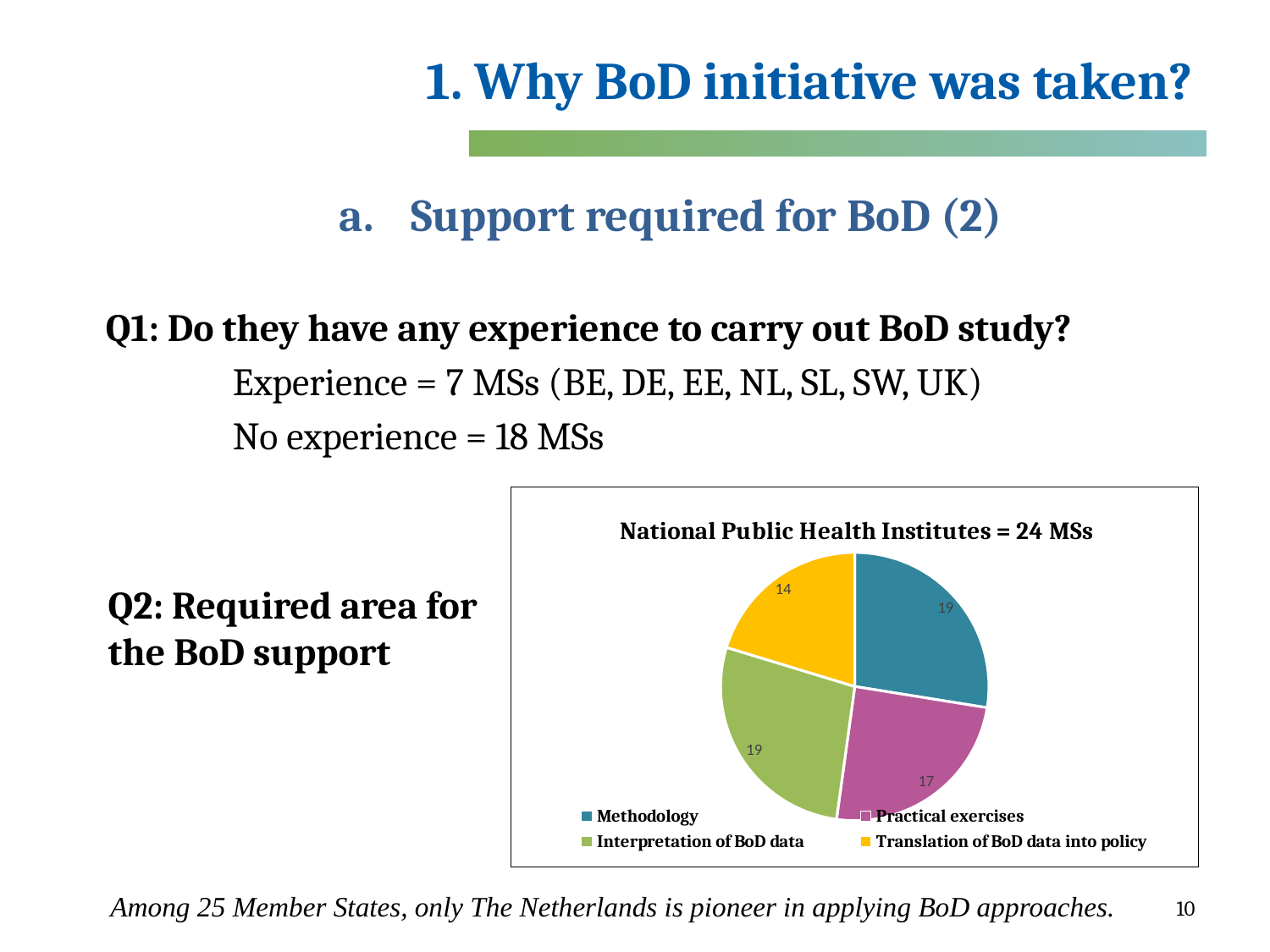
What is the difference between the values for Methodology and Translation of BoD data into policy? 5 What type of chart is shown on the slide? pie chart Which is larger in the pie chart, Methodology or Practical exercises? Methodology What is the title of the pie chart? National Public Health Institutes = 24 MSs What colour is the Translation of BoD data into policy slice in the pie chart? yellow How many slices does the pie chart have? 4 How many entries does the legend of the pie chart list? 4 Which category has the smallest slice in the pie chart? Translation of BoD data into policy What is the value for Translation of BoD data into policy in the pie chart? 14 What is the value for Methodology in the pie chart? 19 What is the value for Practical exercises in the pie chart? 17 What is the value for Interpretation of BoD data in the pie chart? 19